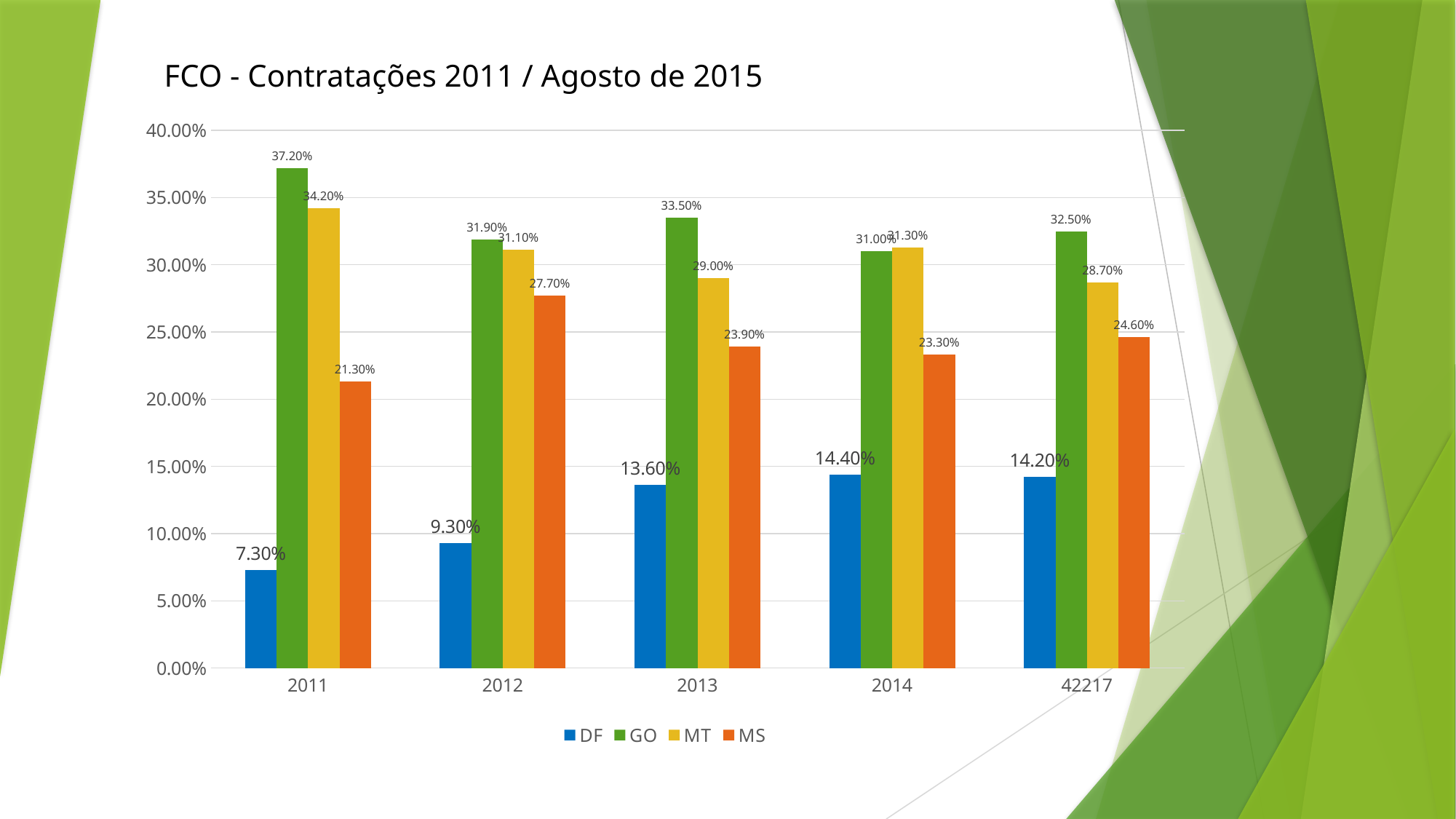
What is the value for GO in 2011? 37.20% Which series has the highest value in 2011? GO How many series does the legend list? 4 What kind of chart is shown on the slide? Bar chart What is the value for DF in 2013? 13.60% What is the title of the chart? FCO - Contratações 2011 / Agosto de 2015 Which series has the lowest value in 2014? DF How many categories are shown on the x axis? 5 What is the difference between the GO and DF values in 2011? 29.90% Which is larger in 2014, the value for GO or the value for MT? MT What is the value for MS in 2012? 27.70% What is the value for MT in the category labelled 42217? 28.70%